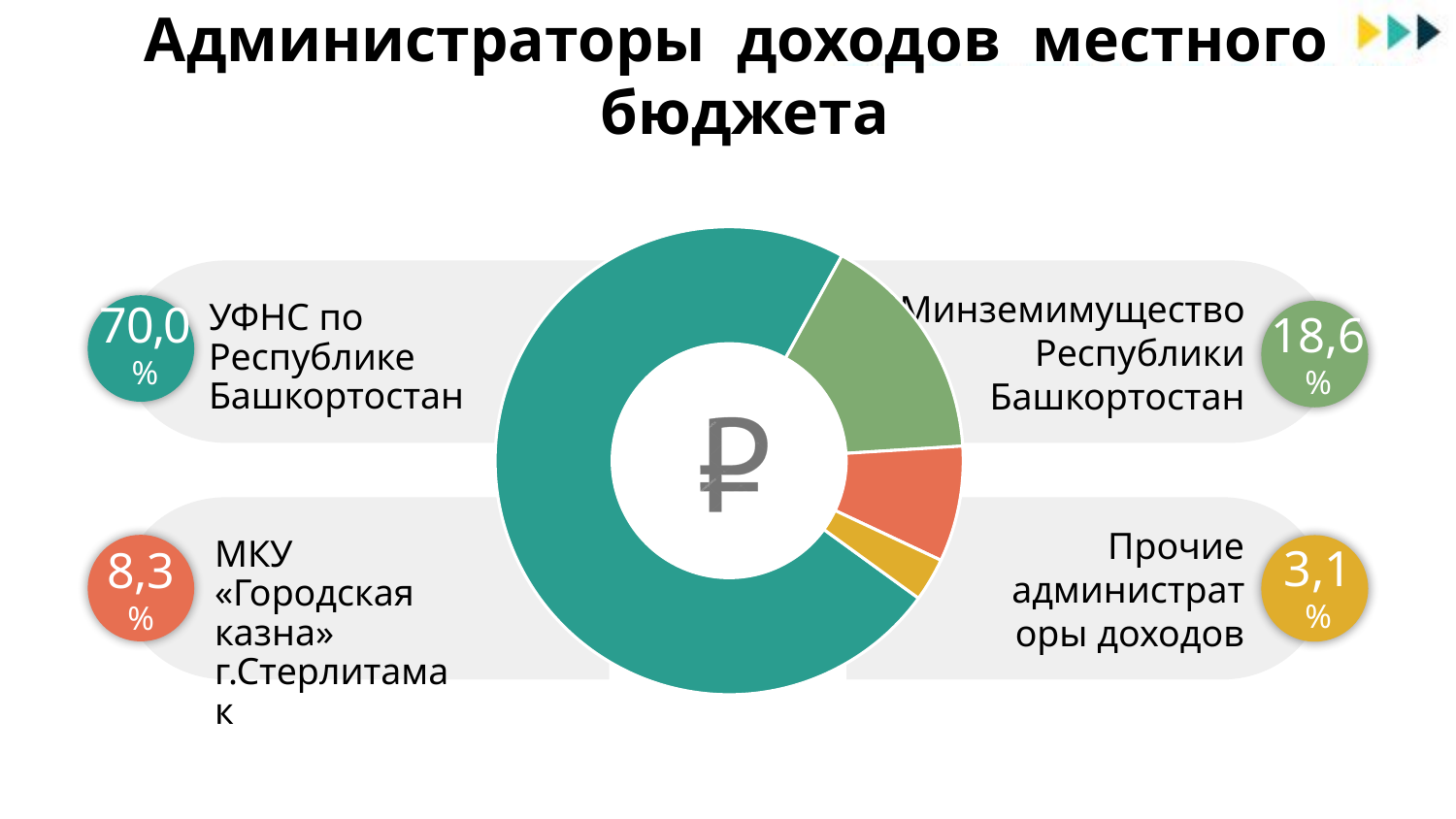
What share is attributed to Минземимущество Республики Башкортостан? 18,6% Which revenue administrator has the smallest share? Прочие администраторы доходов What is the difference in percentage points between УФНС по Республике Башкортостан and Минземимущество Республики Башкортостан? 51,4 Which is larger: the share of МКУ «Городская казна» г.Стерлитамак or the share of Прочие администраторы доходов? МКУ «Городская казна» г.Стерлитамак Which revenue administrator has the largest share? УФНС по Республике Башкортостан What symbol is shown in the centre of the donut chart? ₽ (ruble sign) What share of local budget revenues is administered by УФНС по Республике Башкортостан? 70,0% How many segments does the donut chart have? 4 What kind of chart is shown on the slide? Donut (pie) chart What is the title of the slide? Администраторы доходов местного бюджета What share is attributed to Прочие администраторы доходов? 3,1% What share is attributed to МКУ «Городская казна» г.Стерлитамак? 8,3%